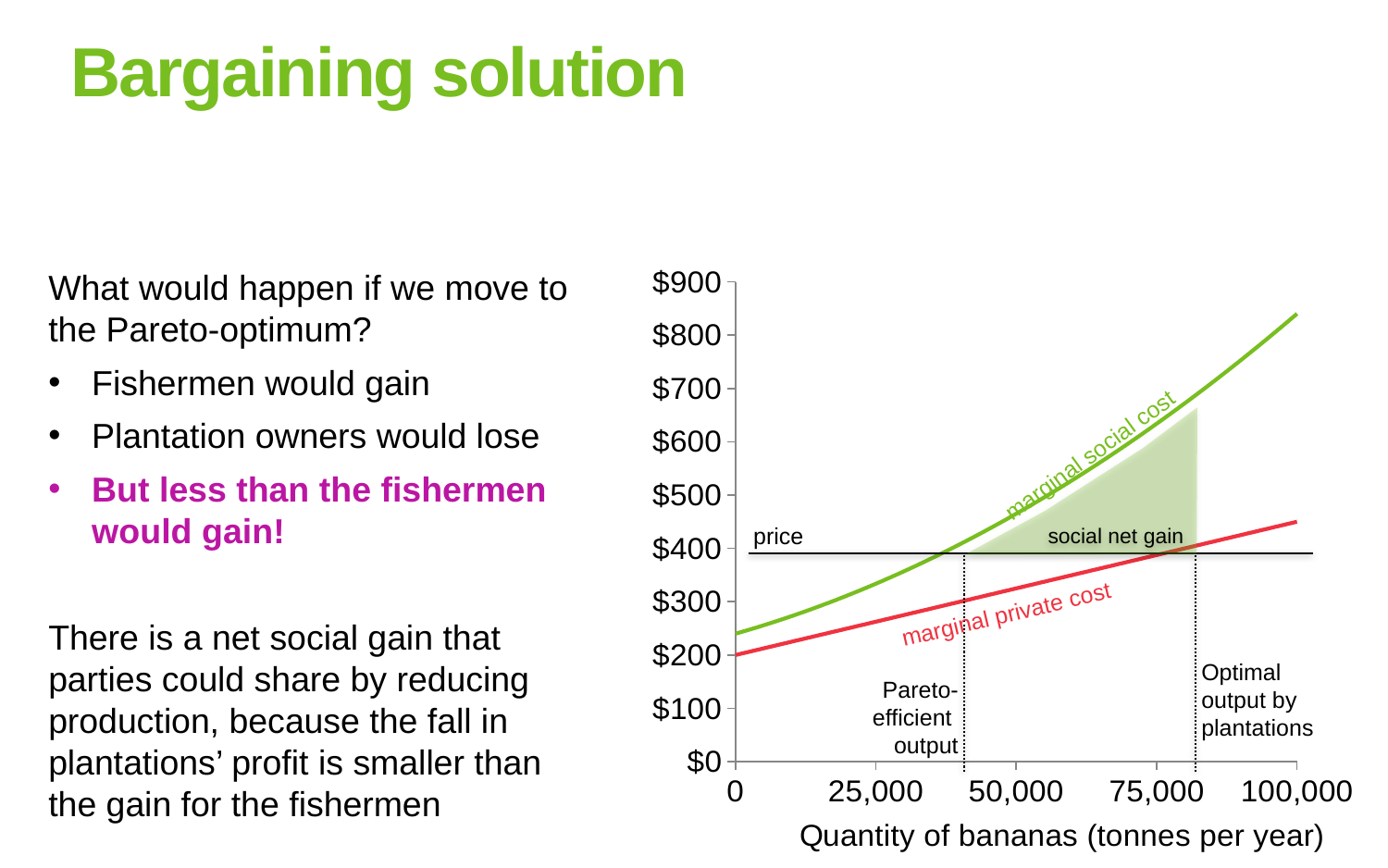
Is the optimal output by plantations greater or less than 75,000 tonnes per year? greater Which curve is higher at a quantity of 100,000: marginal social cost or marginal private cost? marginal social cost Does the marginal social cost curve rise or fall as the quantity of bananas increases? rise What is the label of the shaded area between the two cost curves? social net gain Is the marginal social cost at a quantity of 0 greater or less than $300? less Is the Pareto-efficient output greater or less than 50,000 tonnes per year? less What is the label of the x axis of the chart? Quantity of bananas (tonnes per year) What kind of chart is shown on the slide? line chart